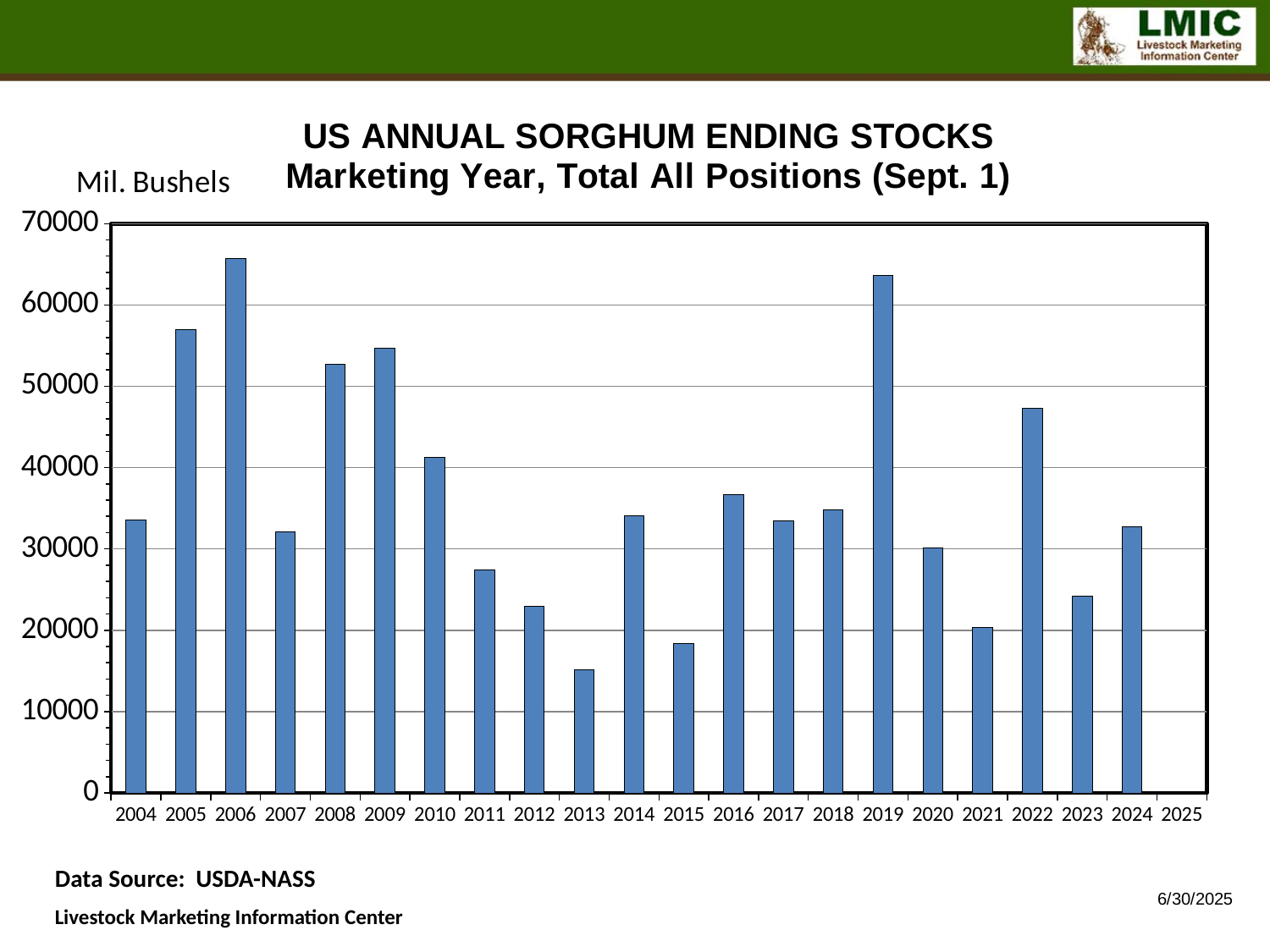
What unit is shown for the y axis of the chart? Mil. Bushels Is the value for 2019 greater or less than 60000? greater Which year has the larger value, 2015 or 2016? 2016 Which year has the larger value, 2005 or 2010? 2005 Do the values rise or fall from 2010 to 2013? fall How many years have a bar plotted on the chart? 21 Is the value for 2022 greater or less than 40000? greater Which year has the highest sorghum ending stocks? 2006 Which year has the lowest sorghum ending stocks? 2013 Is the value for 2013 greater or less than 20000? less What kind of chart is shown on the slide? bar chart